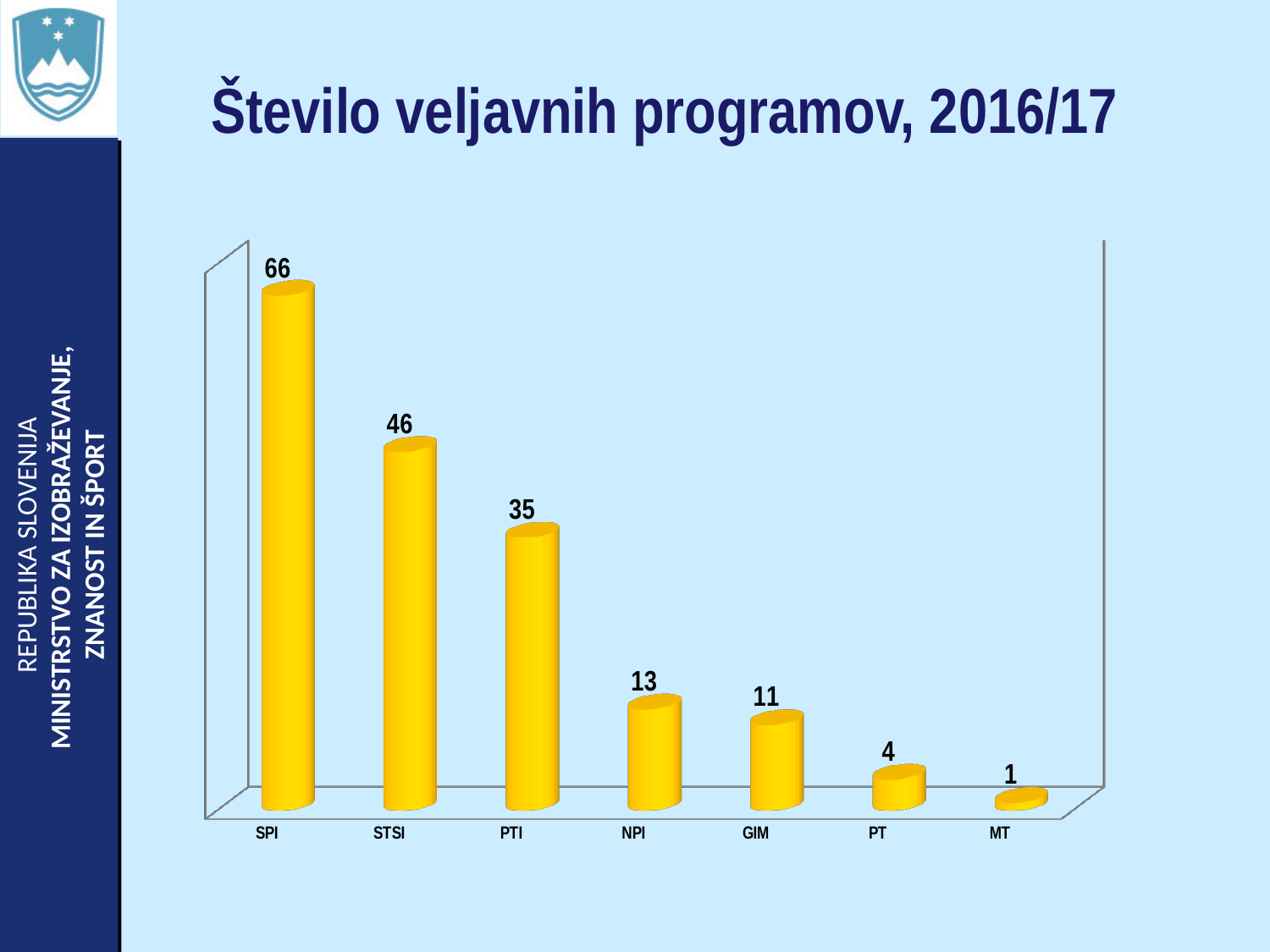
What is the value for GIM? 11 Which category has the highest value? SPI Which category has the lowest value? MT What is the difference between the values for NPI and PT? 9 Which is larger, the value for PTI or the value for NPI? PTI What is the value for SPI? 66 What is the value for MT? 1 Do the values rise or fall from left to right along the x axis? fall What is the value for STSI? 46 What is the difference between the values for SPI and STSI? 20 How many categories are shown on the x axis? 7 What kind of chart is shown on the slide? bar chart